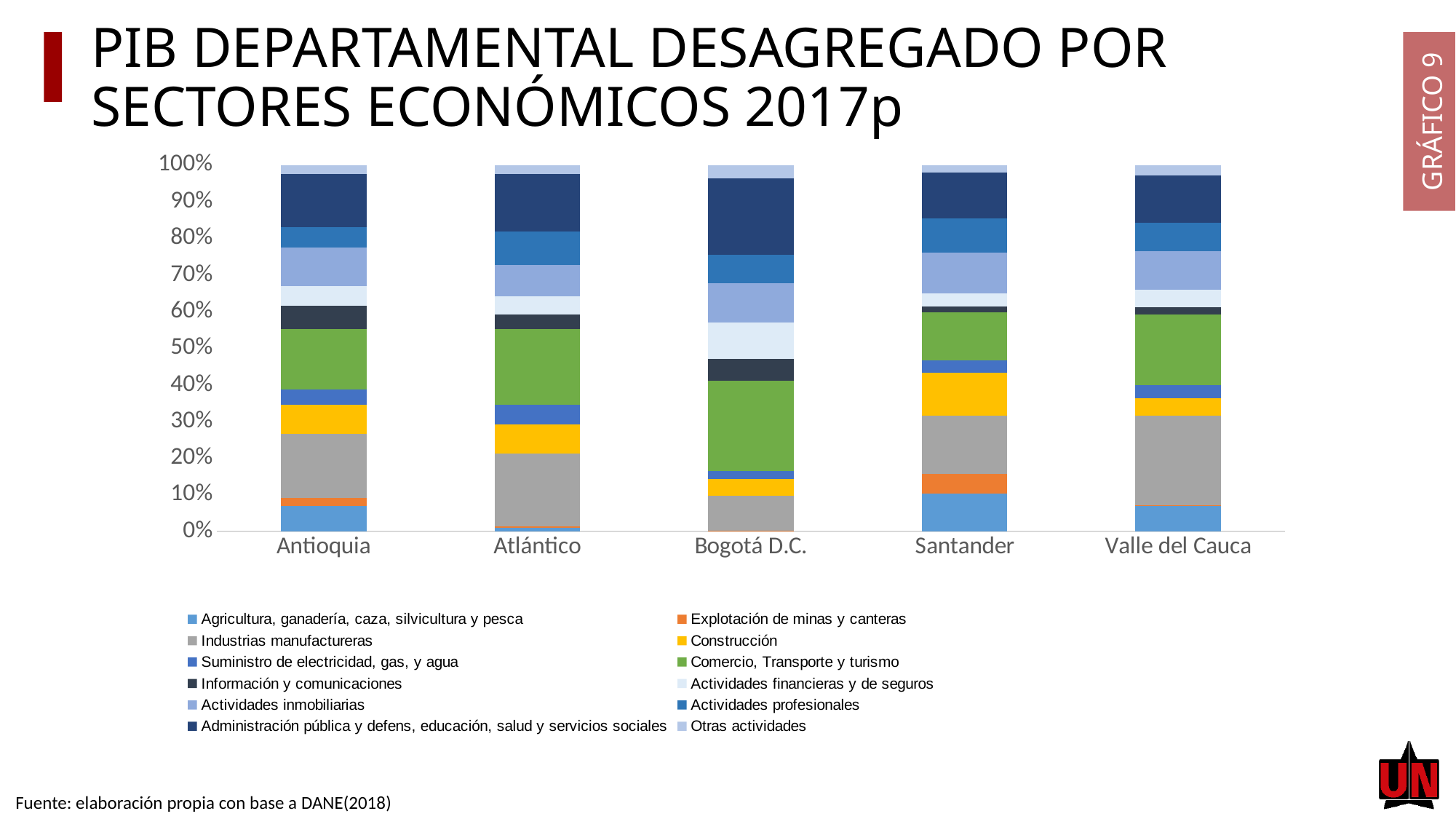
How many departments are shown on the x axis of the chart? 5 Which department has the smallest share for Industrias manufactureras? Bogotá D.C. Is the share of Construcción larger in Santander or in Valle del Cauca? Santander How many series does the legend list? 12 Which department has the largest share for Industrias manufactureras? Valle del Cauca What kind of chart is shown on the slide? Stacked bar chart What is the title of the chart on the slide? PIB DEPARTAMENTAL DESAGREGADO POR SECTORES ECONÓMICOS 2017p Is the share of Agricultura, ganadería, caza, silvicultura y pesca larger in Santander or in Atlántico? Santander Is the share of Comercio, Transporte y turismo in Bogotá D.C. greater or less than 20%? greater Which department has the largest share for Administración pública y defens, educación, salud y servicios sociales? Bogotá D.C. Which department has the largest share for Agricultura, ganadería, caza, silvicultura y pesca? Santander